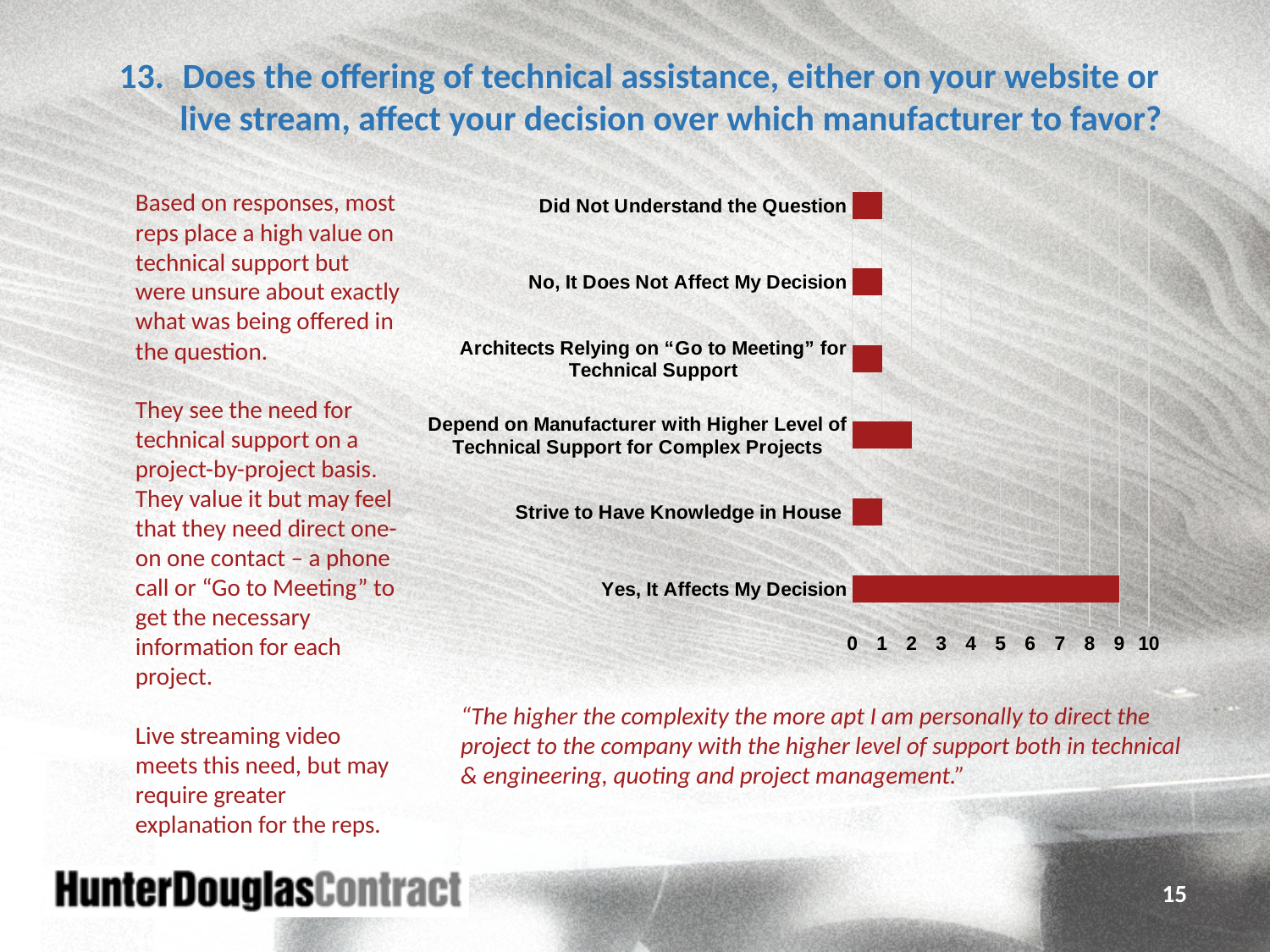
What kind of chart is shown on the slide? bar chart Is the value for "Architects Relying on "Go to Meeting" for Technical Support" greater or less than 5? less What is the value for "Strive to Have Knowledge in House"? 1 Which category has the highest value in the chart? Yes, It Affects My Decision What colour are the bars in the chart? red What is the value for "Did Not Understand the Question"? 1 What is the value for "Depend on Manufacturer with Higher Level of Technical Support for Complex Projects"? 2 What is the difference between the values for "Yes, It Affects My Decision" and "Depend on Manufacturer with Higher Level of Technical Support for Complex Projects"? 7 Which is larger: the value for "Yes, It Affects My Decision" or the value for "No, It Does Not Affect My Decision"? Yes, It Affects My Decision How many categories does the chart show? 6 What is the value for "Yes, It Affects My Decision"? 9 Is the value for "Yes, It Affects My Decision" greater or less than 5? greater